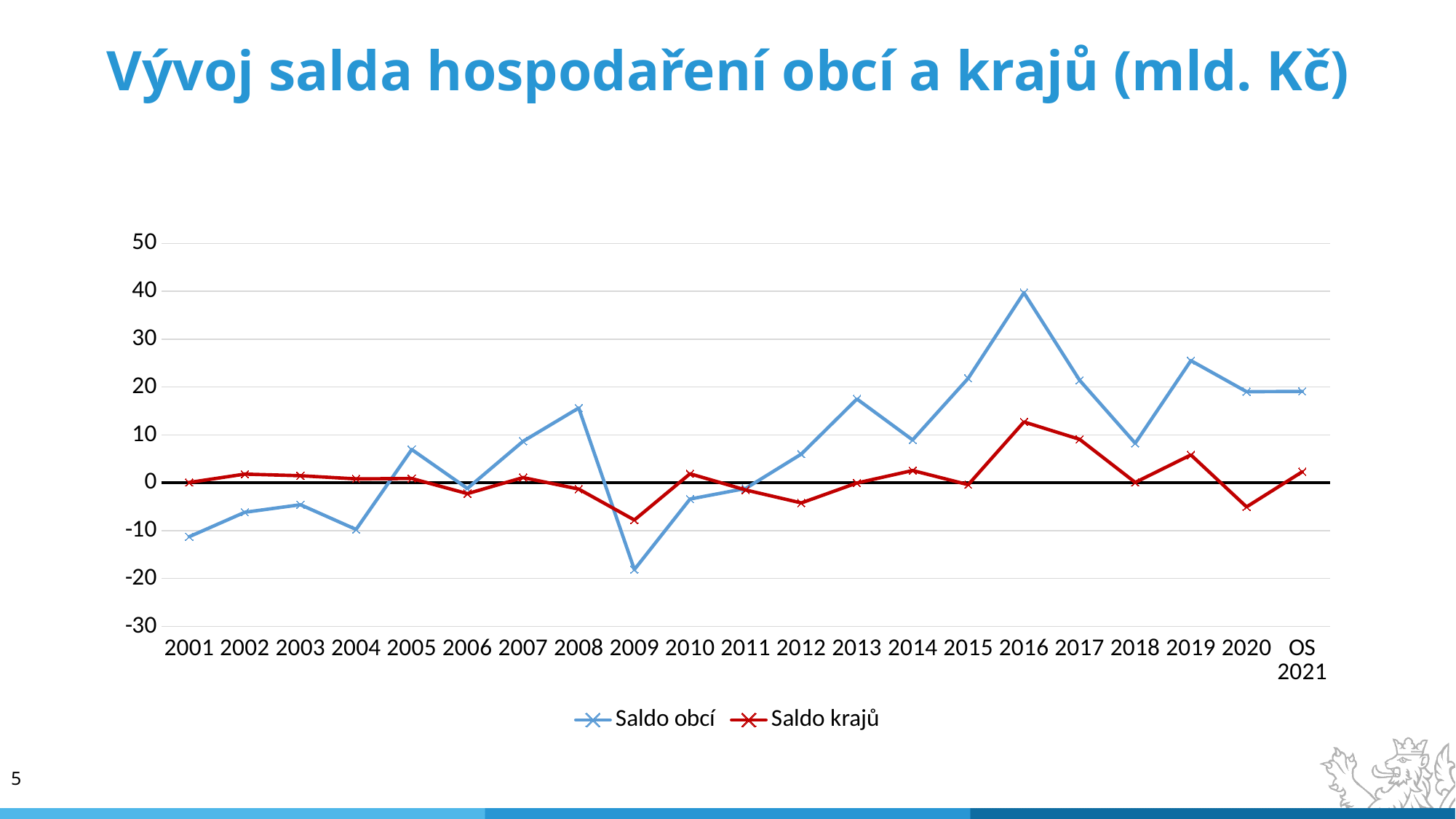
Does Saldo obcí rise or fall from 2016 to 2018? fall What kind of chart is shown on the slide? line chart In 2001, which series has the larger value, Saldo obcí or Saldo krajů? Saldo krajů In which year does Saldo krajů reach its highest value? 2016 How many points are plotted along the x axis for each series? 21 In which year does Saldo obcí reach its lowest value? 2009 How many series does the legend list? 2 In which year does Saldo obcí reach its highest value? 2016 Is the value of Saldo krajů in 2016 greater or less than 10? greater What is the title of the chart? Vývoj salda hospodaření obcí a krajů (mld. Kč) Is the value of Saldo obcí in 2009 greater or less than -10? less Is the value of Saldo obcí in 2016 greater or less than 30? greater